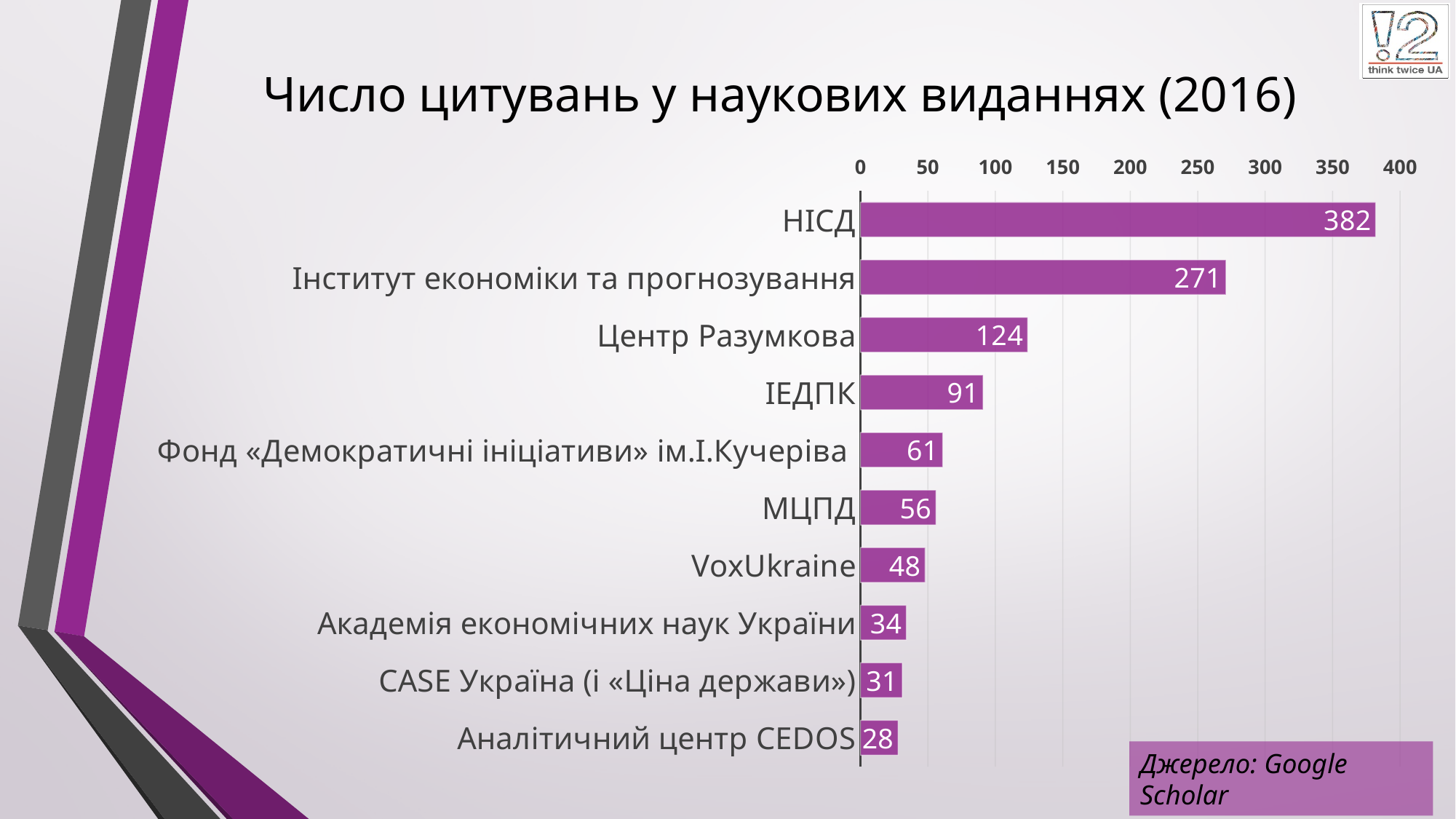
What is the title of the chart? Число цитувань у наукових виданнях (2016) What kind of chart is shown on the slide? bar chart Which has a larger value, Центр Разумкова or ІЕДПК? Центр Разумкова What is the number of citations for НІСД? 382 Is the value for Інститут економіки та прогнозування greater or less than 250? greater What is the difference between the values for ІЕДПК and МЦПД? 35 What is the difference between the values for НІСД and Інститут економіки та прогнозування? 111 What is the value shown for Центр Разумкова? 124 What is the value shown for VoxUkraine? 48 How many organisations are shown in the chart? 10 Which organisation has the lowest number of citations? Аналітичний центр CEDOS Which organisation has the highest number of citations? НІСД